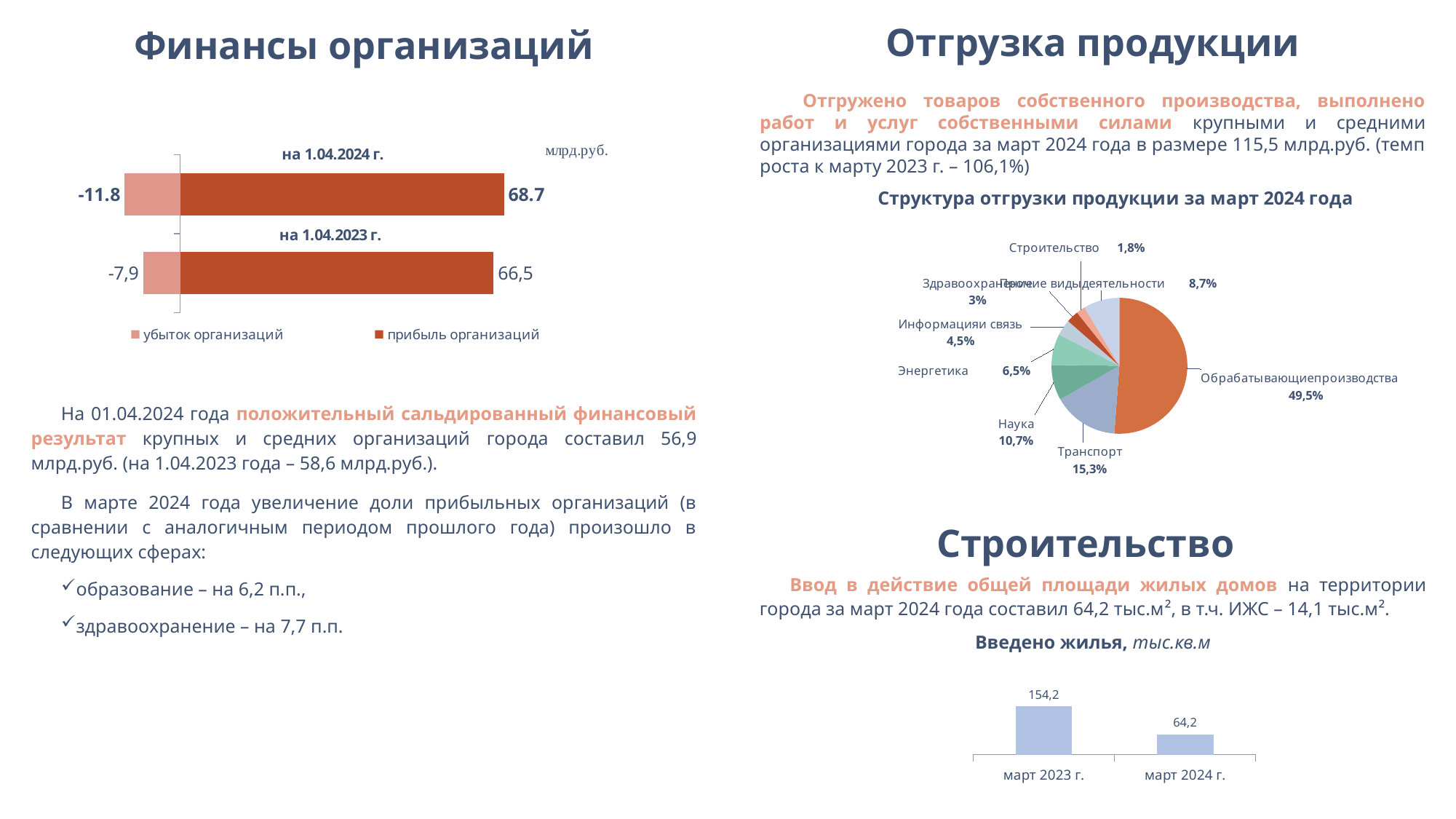
In the 'Финансы организаций' chart, what unit is shown next to the chart? млрд.руб. In the pie chart 'Структура отгрузки продукции за март 2024 года', which category has the smallest share? Строительство In the pie chart 'Структура отгрузки продукции за март 2024 года', what share does Транспорт have? 15,3% In the 'Финансы организаций' bar chart, what is the value for убыток организаций на 1.04.2023 г.? -7,9 In the 'Финансы организаций' bar chart, how many series does the legend list? 2 In the 'Финансы организаций' bar chart, which period has the larger прибыль организаций value, на 1.04.2024 г. or на 1.04.2023 г.? на 1.04.2024 г. In the 'Финансы организаций' bar chart, what is the value for прибыль организаций на 1.04.2024 г.? 68.7 In the pie chart 'Структура отгрузки продукции за март 2024 года', how many slices are there? 8 In the 'Введено жилья, тыс.кв.м' chart, what is the value for март 2023 г.? 154,2 In the 'Введено жилья, тыс.кв.м' chart, what is the difference between март 2023 г. and март 2024 г.? 90,0 What kind of chart is 'Введено жилья, тыс.кв.м'? bar chart In the pie chart 'Структура отгрузки продукции за март 2024 года', what share does Обрабатывающие производства have? 49,5%